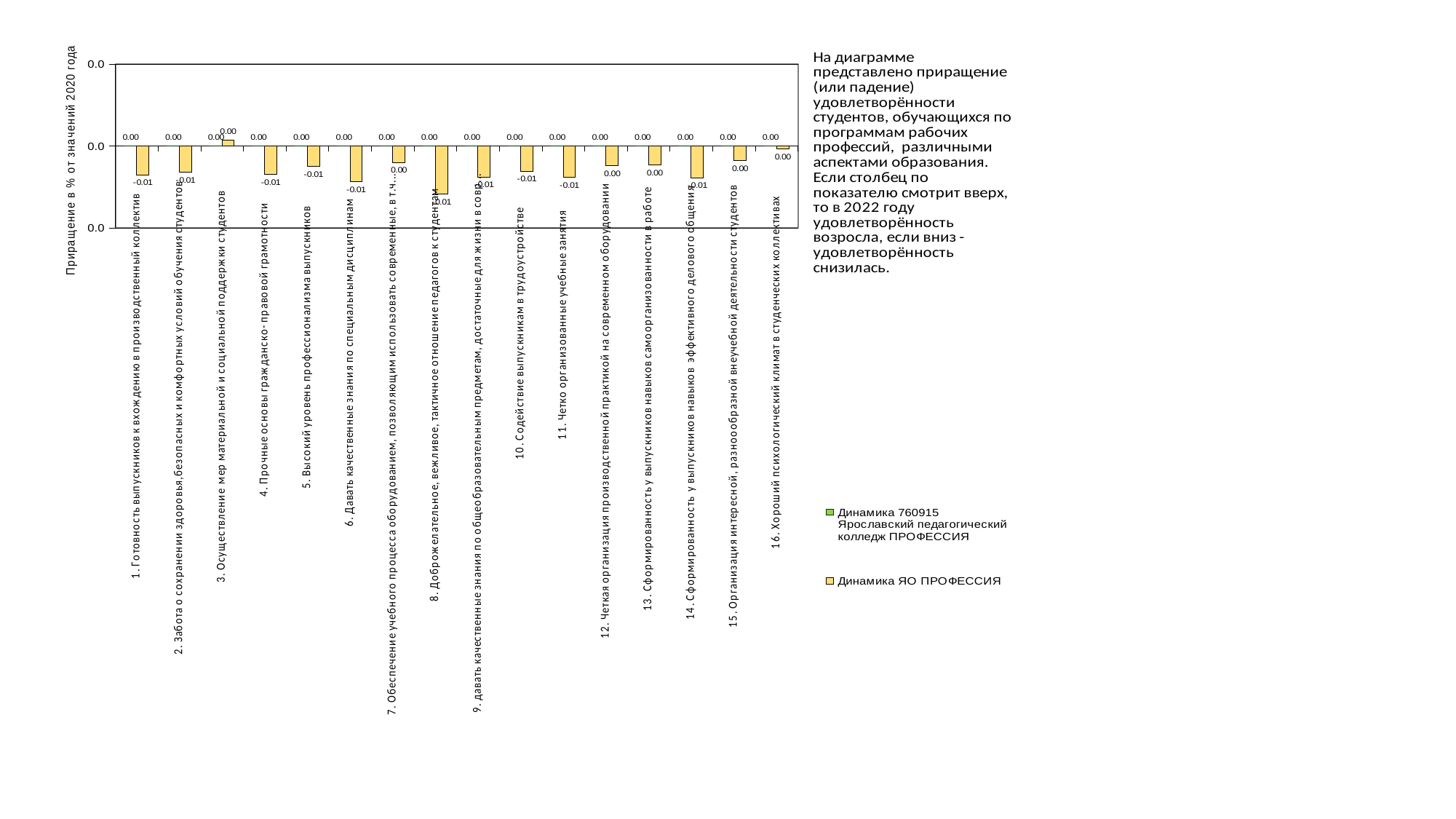
How many categories are plotted along the x axis of the chart? 16 How many series does the chart's legend list? 2 What is the value of the 'Динамика 760915 Ярославский педагогический колледж ПРОФЕССИЯ' series for category '5. Высокий уровень профессионализма выпускников'? 0.00 What is the value of the 'Динамика ЯО ПРОФЕССИЯ' series for category '1. Готовность выпускников к вхождению в производственный коллектив'? -0.01 What is the value of the 'Динамика ЯО ПРОФЕССИЯ' series for category '16. Хороший психологический климат в студенческих коллективах'? 0.00 What is the title of the chart's vertical axis? Приращение в % от значений 2020 года What is the value of the 'Динамика ЯО ПРОФЕССИЯ' series for category '14. Сформированность у выпускников навыков эффективного делового общения'? -0.01 What is the value of the 'Динамика ЯО ПРОФЕССИЯ' series for category '12. Четкая организация производственной практикой на современном оборудовании'? 0.00 What kind of chart is shown on the slide? Bar chart Which series in the legend is shown in yellow? Динамика ЯО ПРОФЕССИЯ Which category is the only one where the 'Динамика ЯО ПРОФЕССИЯ' bar points upward (above zero)? 3. Осуществление мер материальной и социальной поддержки студентов For the 'Динамика ЯО ПРОФЕССИЯ' series, which is larger: the value for category 1 (Готовность выпускников к вхождению в производственный коллектив) or category 12 (Четкая организация производственной практикой на современном оборудовании)? Category 12